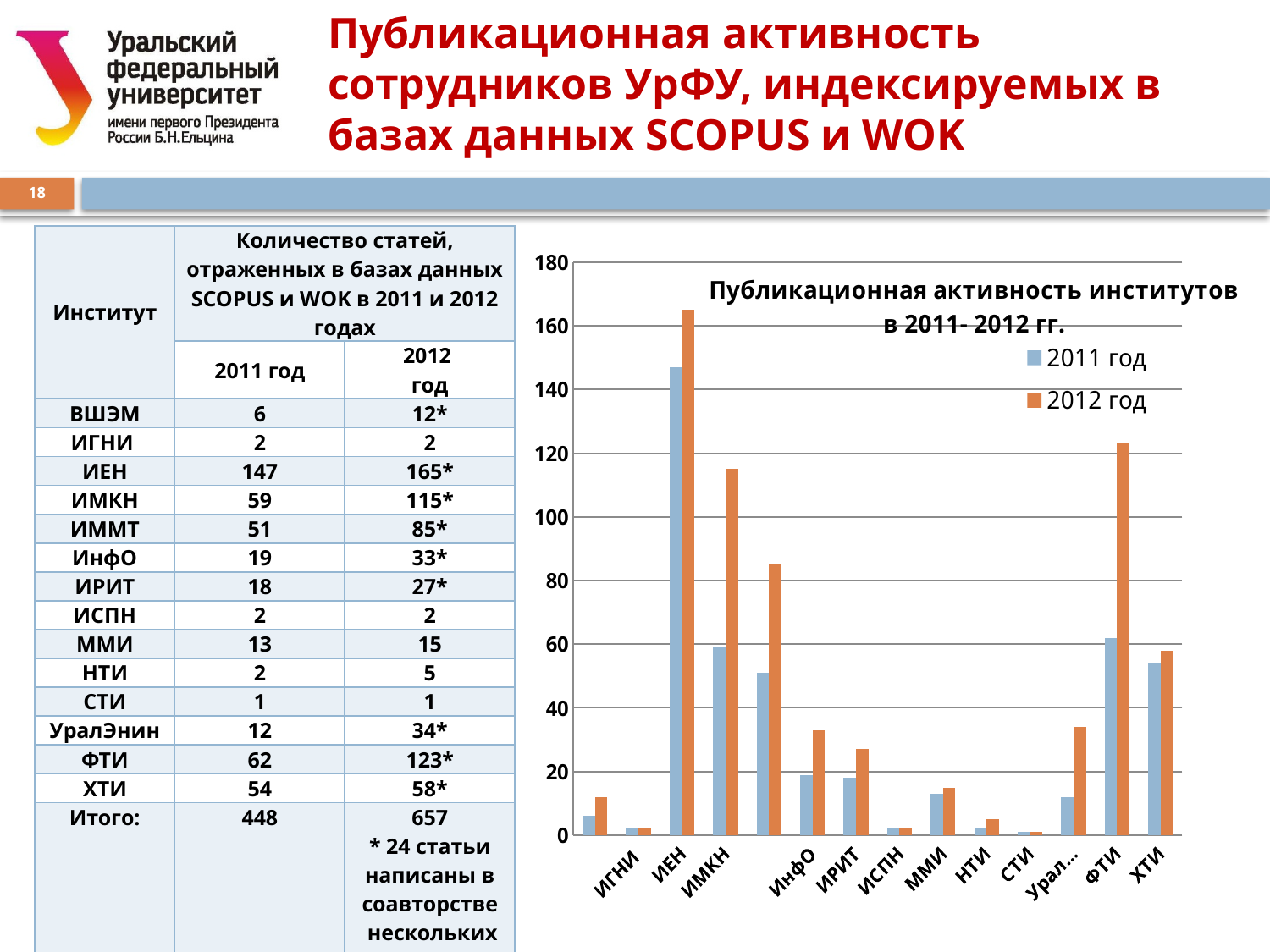
What is the 2011 год value for ФТИ? 62 What are the two series named in the chart legend? 2011 год and 2012 год Is the 2012 год value for ИнфО greater or less than 40? less Which institute has the highest 2012 год bar in the chart? ИЕН What is the title of the chart? Публикационная активность институтов в 2011- 2012 гг. Which is larger in the chart: the 2012 год value for ИМКН or the 2012 год value for ХТИ? ИМКН Which labeled institute has the lowest 2012 год bar in the chart? СТИ Is the 2011 год value for ИЕН greater or less than 140? greater What is the 2011 год value for ИЕН? 147 Is the 2012 год value for ФТИ greater or less than 100? greater What kind of chart is shown on the slide? bar chart How many series does the chart legend list? 2